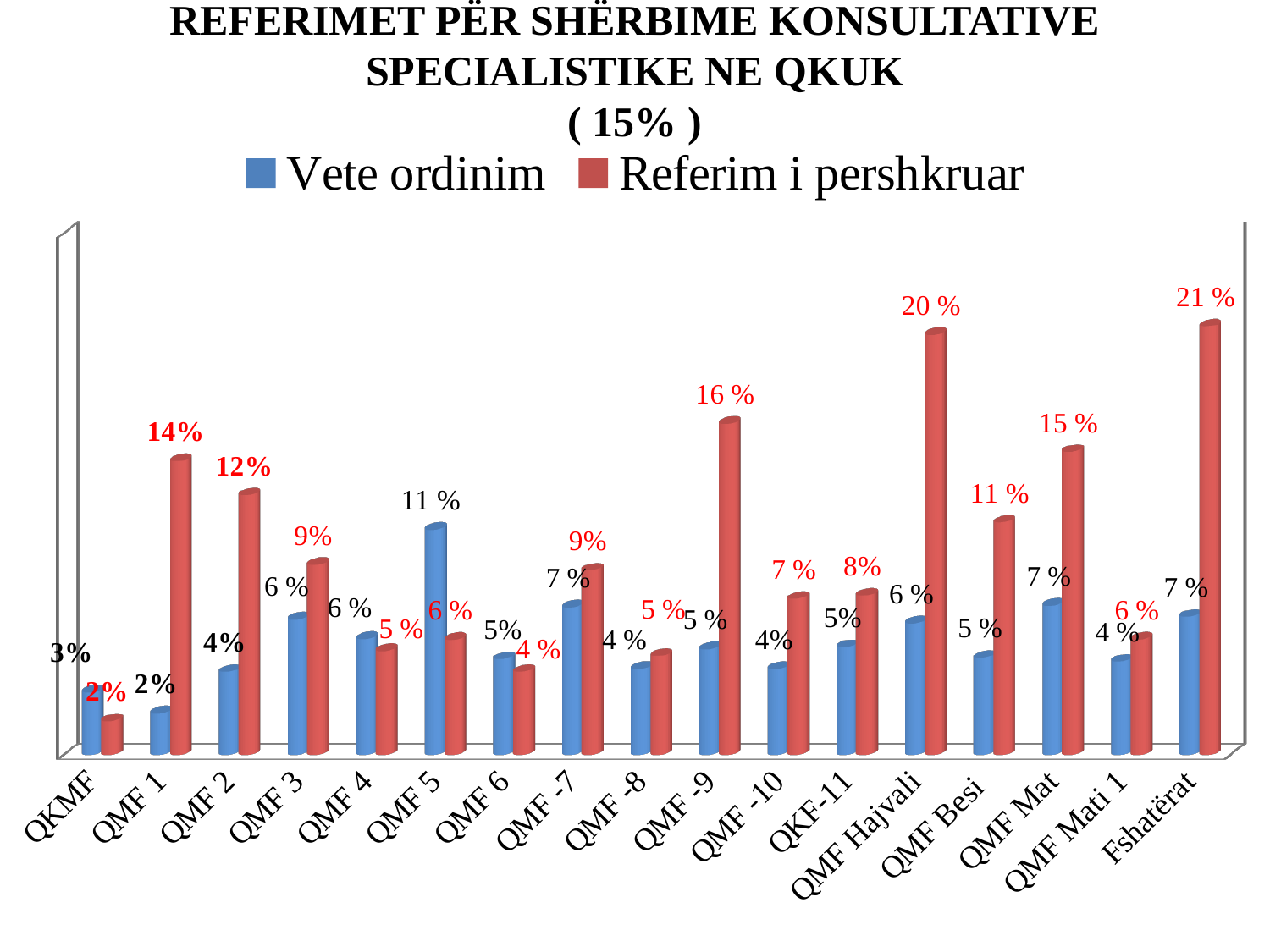
What is the Referim i pershkruar value for Fshatërat? 21 % Which category has the highest Referim i pershkruar value? Fshatërat Which colour represents the Referim i pershkruar series? Red Which category has the highest Vete ordinim value? QMF 5 What is the Referim i pershkruar value for QMF Hajvali? 20 % How many series does the legend list? 2 What kind of chart is shown on the slide? Bar chart What is the Vete ordinim value for QMF 5? 11 % Which is larger for QMF 4: Vete ordinim or Referim i pershkruar? Vete ordinim What is the difference between the Referim i pershkruar and Vete ordinim values for QMF -9? 11 % How many categories are shown on the x axis? 17 Which category has the lowest Referim i pershkruar value? QKMF